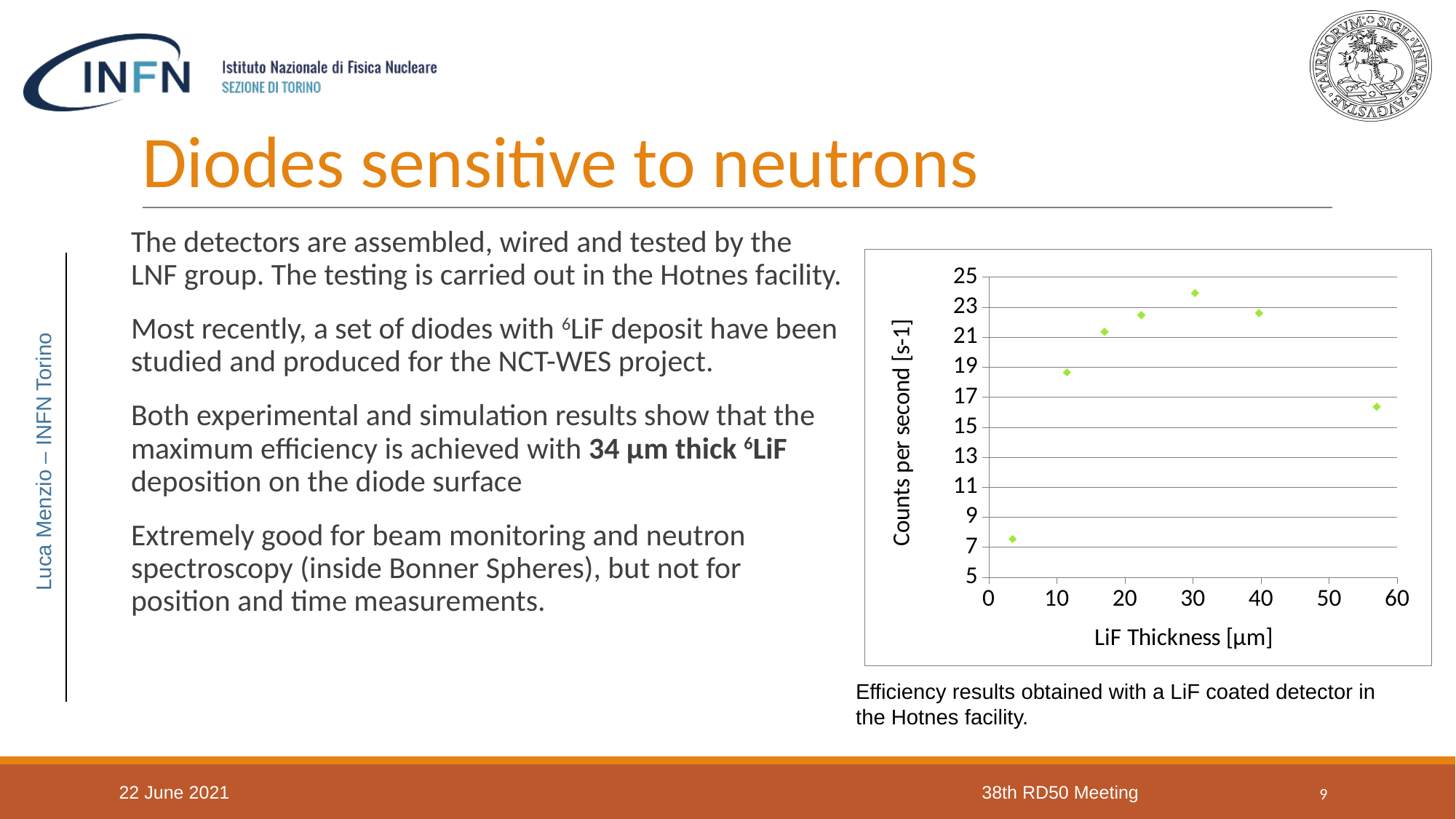
What kind of chart is shown on the slide? scatter plot What is the label of the y axis of the chart? Counts per second [s-1] What is the maximum value shown on the y axis of the chart? 25 How do the counts per second change as LiF thickness increases from 0 to 60 µm? rise then fall Is the counts-per-second value of the leftmost data point (near 0 µm) greater or less than 9? less Which data point has the lowest counts per second: the leftmost point or the rightmost point? the leftmost point Which data point has the highest counts per second: the one near 30 µm or the one near 40 µm? the one near 30 µm Is the counts-per-second value of the data point near 30 µm greater or less than 23? greater Is the counts-per-second value of the data point near 10 µm greater or less than 17? greater What is the label of the x axis of the chart? LiF Thickness [µm] How many data points are plotted in the chart? 7